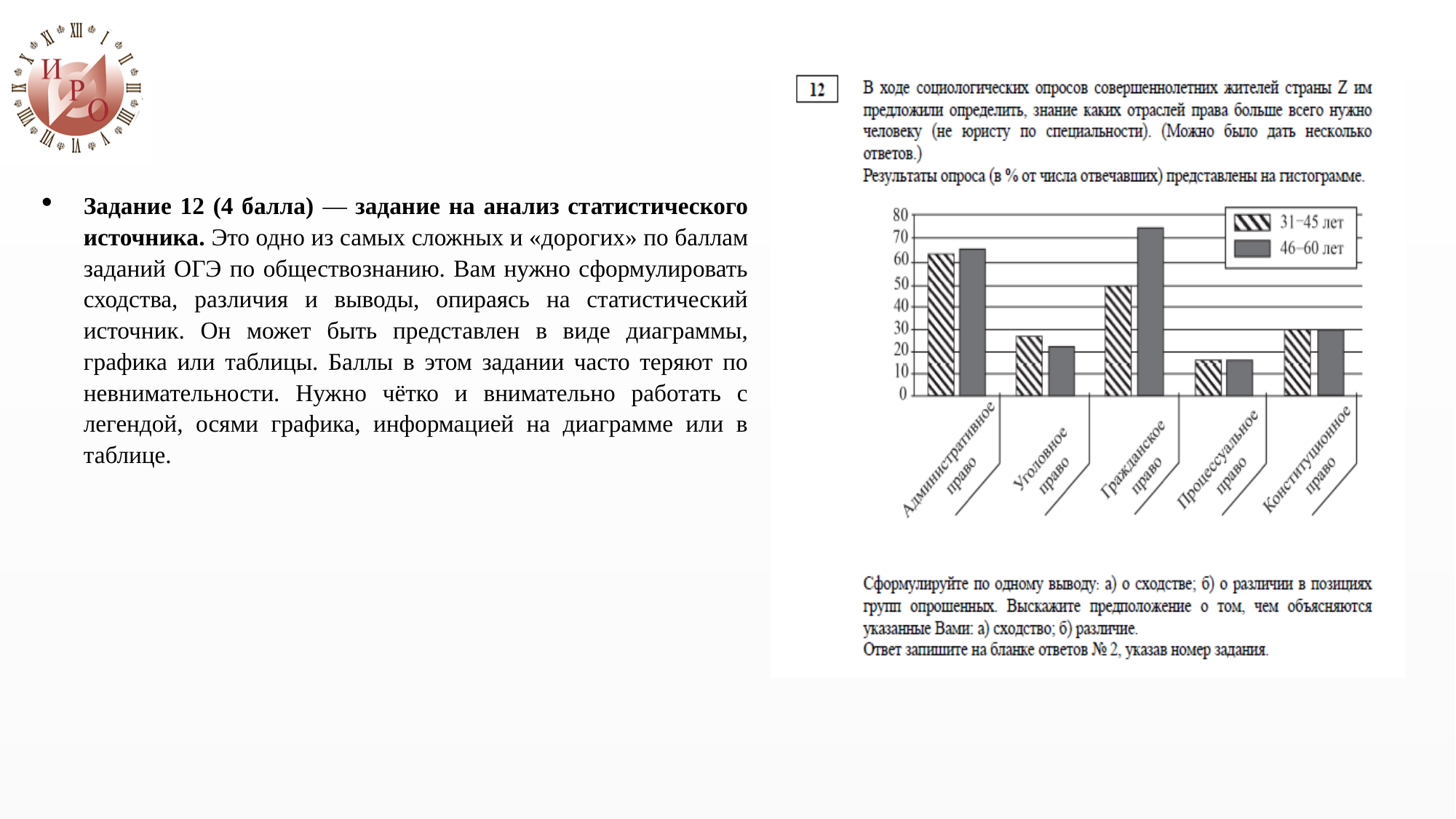
Which category has the lowest value in the 46–60 лет series? Процессуальное право Which series is shown with diagonal hatching in the chart's legend? 31–45 лет Which category has the highest value in the 46–60 лет series? Гражданское право What is the value for Конституционное право in the 46–60 лет series? 30 Is the value for Административное право in the 46–60 лет series greater or less than 60? greater Is the value for Процессуальное право in the 31–45 лет series greater or less than 20? less What kind of chart is shown on the slide? bar chart For Гражданское право, which series has the larger value: 31–45 лет or 46–60 лет? 46–60 лет Which category has the highest value in the 31–45 лет series? Административное право How many categories (branches of law) are shown on the x axis of the chart? 5 What is the value for Гражданское право in the 31–45 лет series? 50 How many series does the chart's legend list? 2